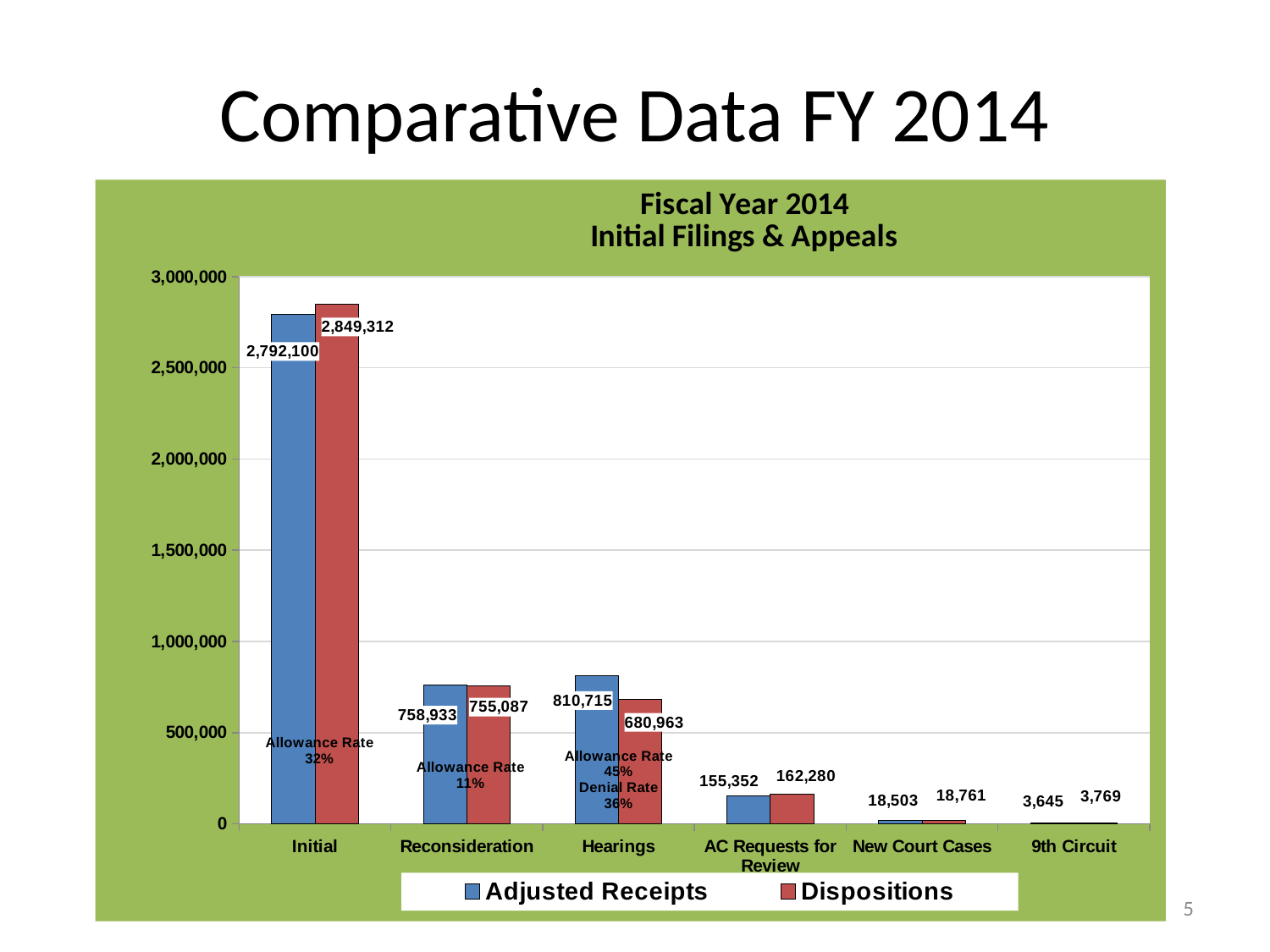
What is the difference between Dispositions and Adjusted Receipts for Initial? 57,212 What allowance rate is annotated for Reconsideration? 11% Which is larger for Hearings, Adjusted Receipts or Dispositions? Adjusted Receipts What is the Adjusted Receipts value for AC Requests for Review? 155,352 What is the Adjusted Receipts value for Initial? 2,792,100 How many categories are shown on the x axis? 6 What is the Dispositions value for 9th Circuit? 3,769 Which category has the highest Adjusted Receipts value? Initial How many series does the legend list? 2 What kind of chart is shown? Bar chart What is the Dispositions value for Hearings? 680,963 Which category has the lowest Dispositions value? 9th Circuit